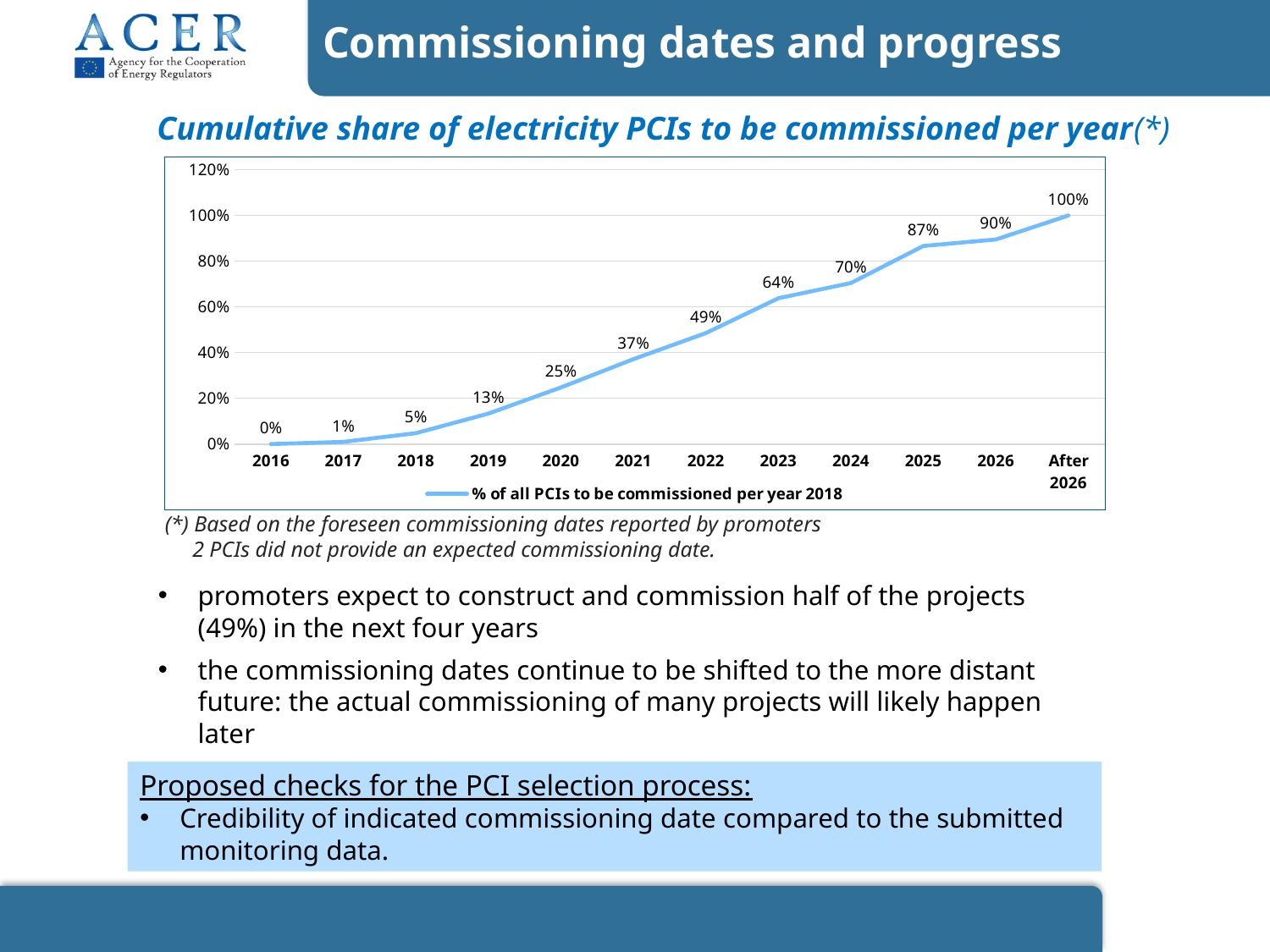
How many categories are shown on the x axis? 12 What is the difference between the values for 2024 and 2023? 6% What is the cumulative share of electricity PCIs to be commissioned by 2022? 49% What is the difference between the values for 2021 and 2020? 12% Which is larger, the value for 2018 or the value for 2020? 2020 What is the cumulative share of electricity PCIs to be commissioned by 2019? 13% Do the values rise or fall along the x axis from 2016 to After 2026? Rise Is the value for 2023 greater or less than 60%? greater Which category on the x axis has the highest value? After 2026 What value is shown for 2025? 87% What kind of chart is shown on the slide? Line chart Which year has the lowest value? 2016